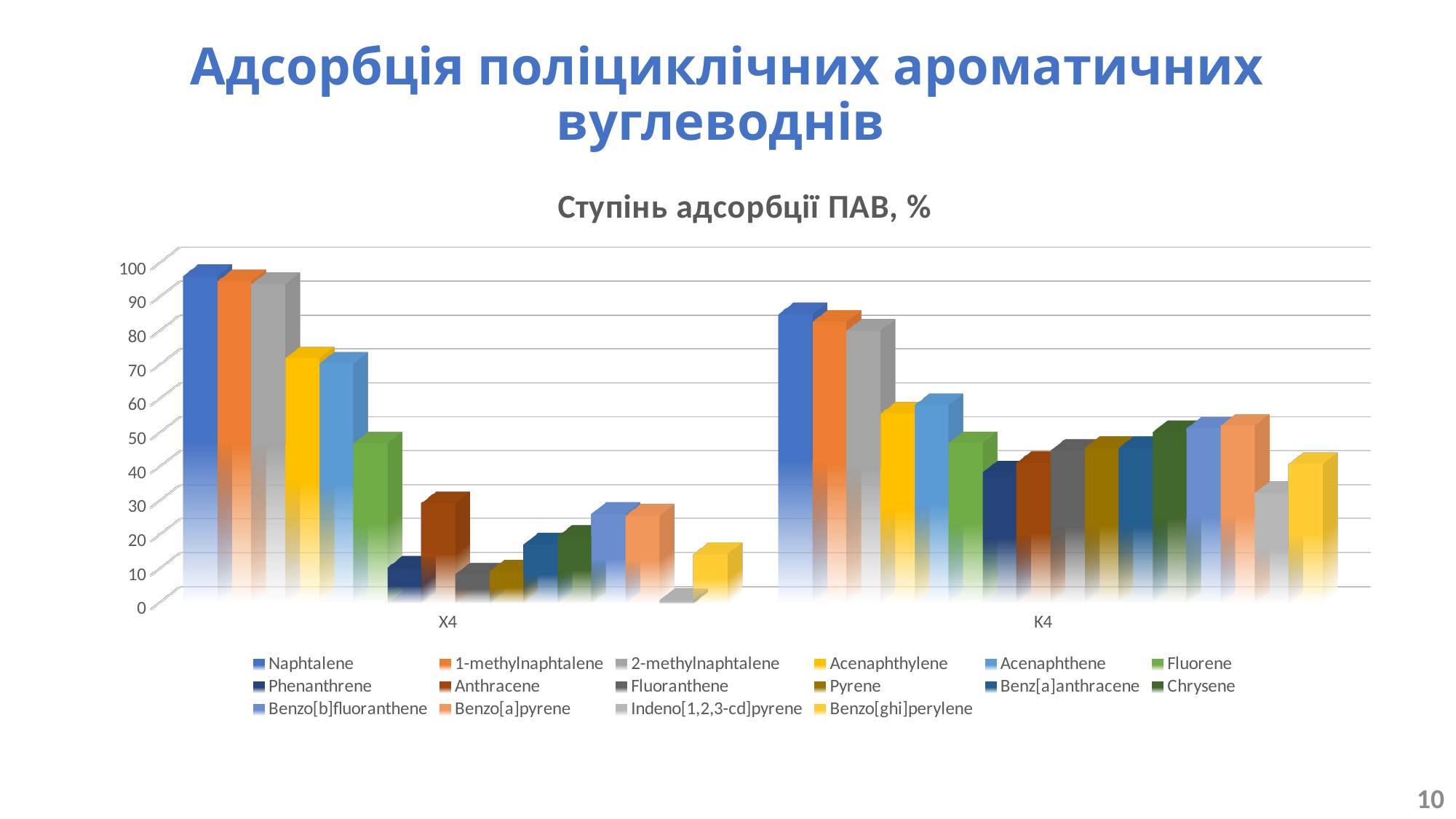
Which series has the highest value for K4? Naphtalene Which series has the highest value for X4? Naphtalene What is the title of the chart? Ступінь адсорбції ПАВ, % Which series has the lowest value for K4? Indeno[1,2,3-cd]pyrene What kind of chart is shown on the slide? bar chart Is the value for Naphtalene at X4 greater or less than 90? greater Is the value for Naphtalene larger for X4 or for K4? X4 How many series does the legend list? 16 How many categories are shown on the x axis? 2 Which series has the lowest value for X4? Indeno[1,2,3-cd]pyrene Is the value for Anthracene at X4 greater or less than 40? less For X4, which is larger: Fluorene or Anthracene? Fluorene